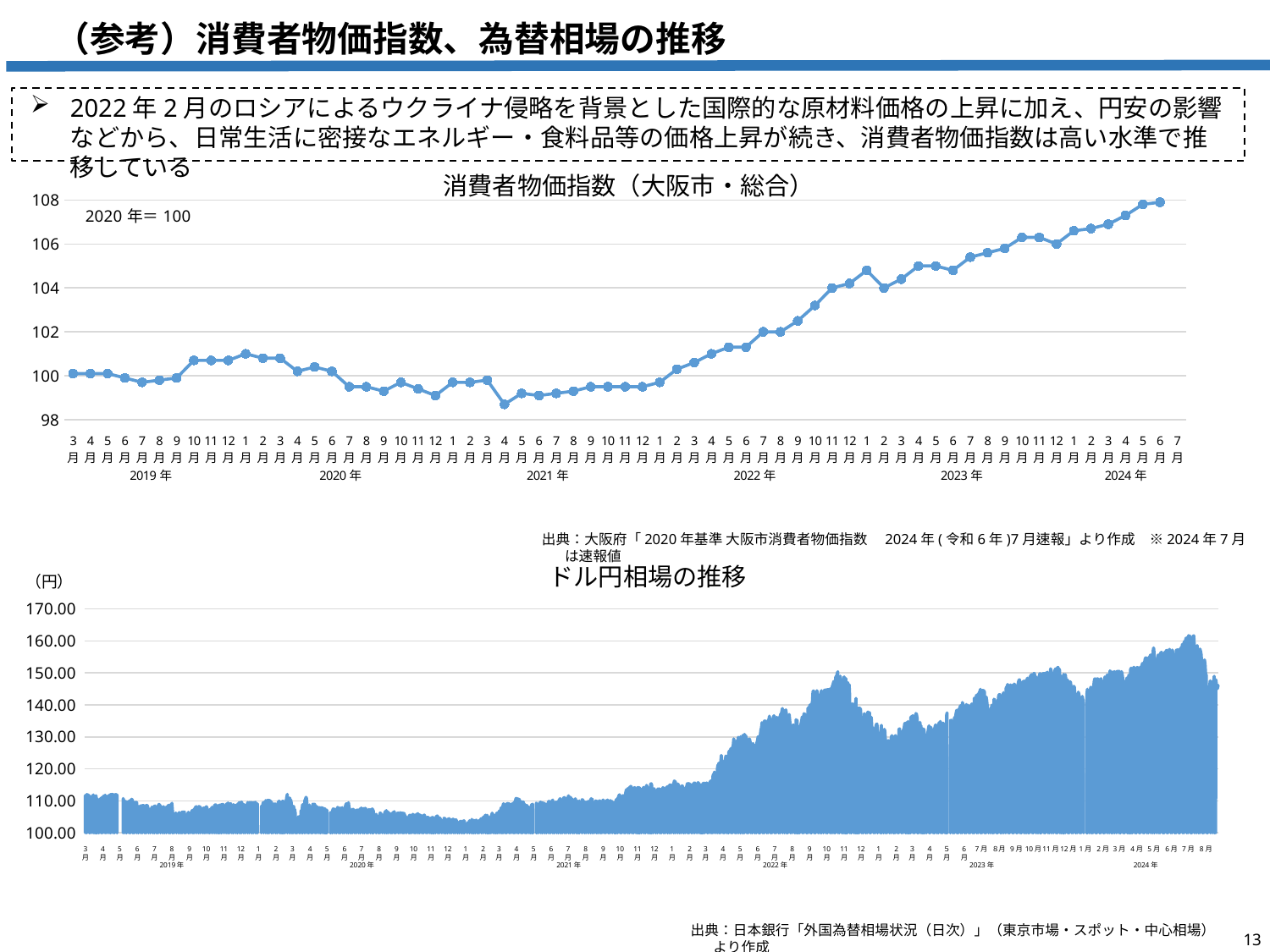
In the bottom chart ドル円相場の推移, do the values generally rise or fall from 2021年 to 2024年? rise In the top chart 消費者物価指数（大阪市・総合）, is the value for 7月 2024年 greater or less than 106? greater In the bottom chart ドル円相場の推移, is the value for 3月 2019年 greater or less than 120.00? less In the top chart 消費者物価指数（大阪市・総合）, which month has the lowest value? 4月 2021年 What kind of chart is the bottom chart titled ドル円相場の推移? area chart What base year note is shown on the top chart 消費者物価指数（大阪市・総合）? 2020年＝100 In the top chart 消費者物価指数（大阪市・総合）, do the values generally rise or fall from 2022年 to 2024年? rise In the top chart 消費者物価指数（大阪市・総合）, which is larger, the value for 1月 2020年 or the value for 4月 2021年? 1月 2020年 What kind of chart is the top chart titled 消費者物価指数（大阪市・総合）? line chart In the bottom chart ドル円相場の推移, is the value for 7月 2024年 greater or less than 150.00? greater In the top chart 消費者物価指数（大阪市・総合）, which month has the highest value? 7月 2024年